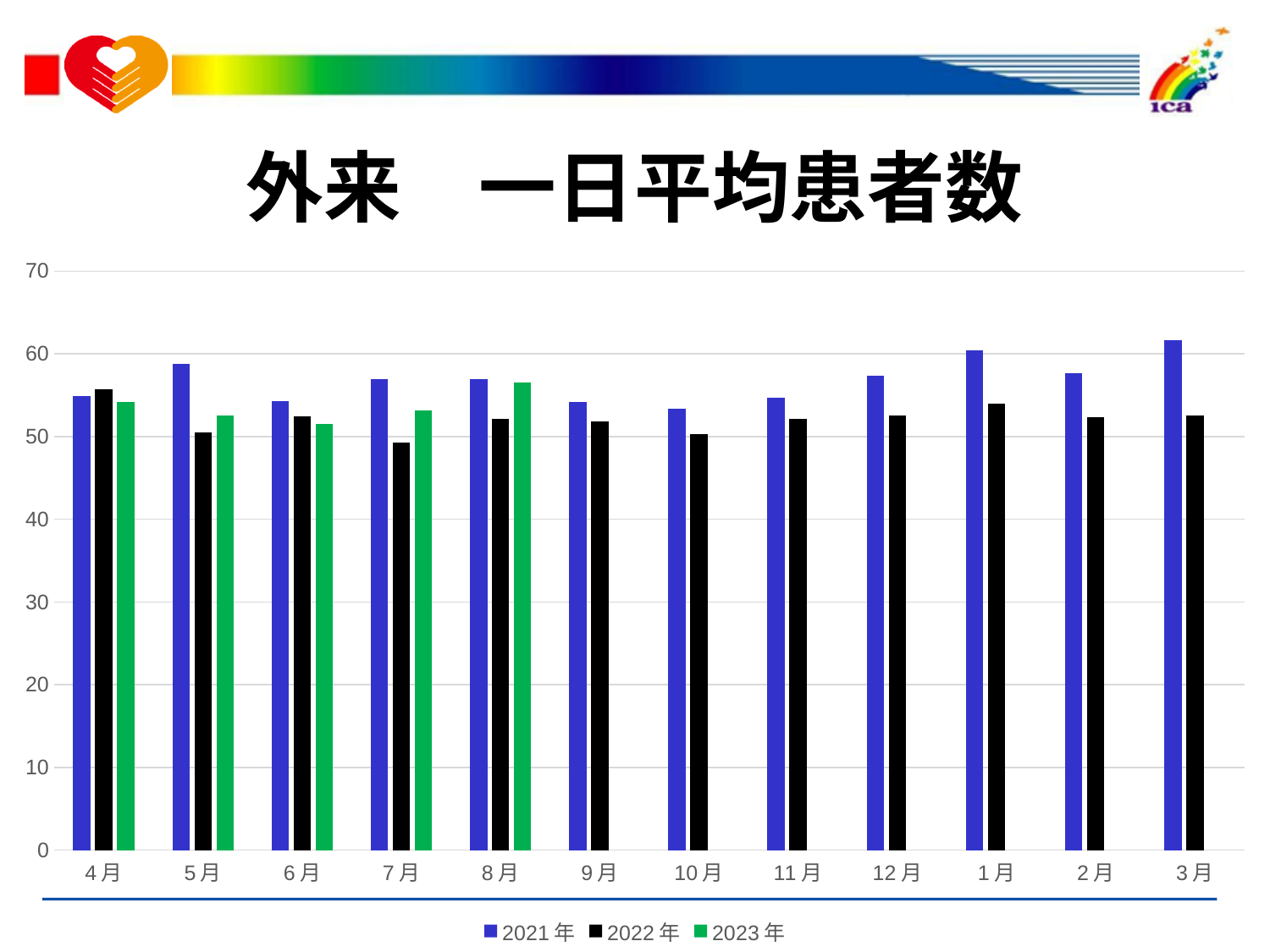
Which month has the highest value for the 2023年 series? 8月 Which month has the lowest value for the 2022年 series? 7月 What is the title of the chart? 外来 一日平均患者数 How many month categories are shown on the x axis? 12 Is the 2022年 value for 7月 greater or less than 50? less In 5月, which series has the larger value, 2021年 or 2022年? 2021年 How many series does the legend list? 3 Which month has the highest value for the 2021年 series? 3月 Which month has the highest value for the 2022年 series? 4月 For how many months is a 2023年 bar plotted? 5 Is the 2021年 value for 3月 greater or less than 60? greater What kind of chart is shown on the slide? Bar chart